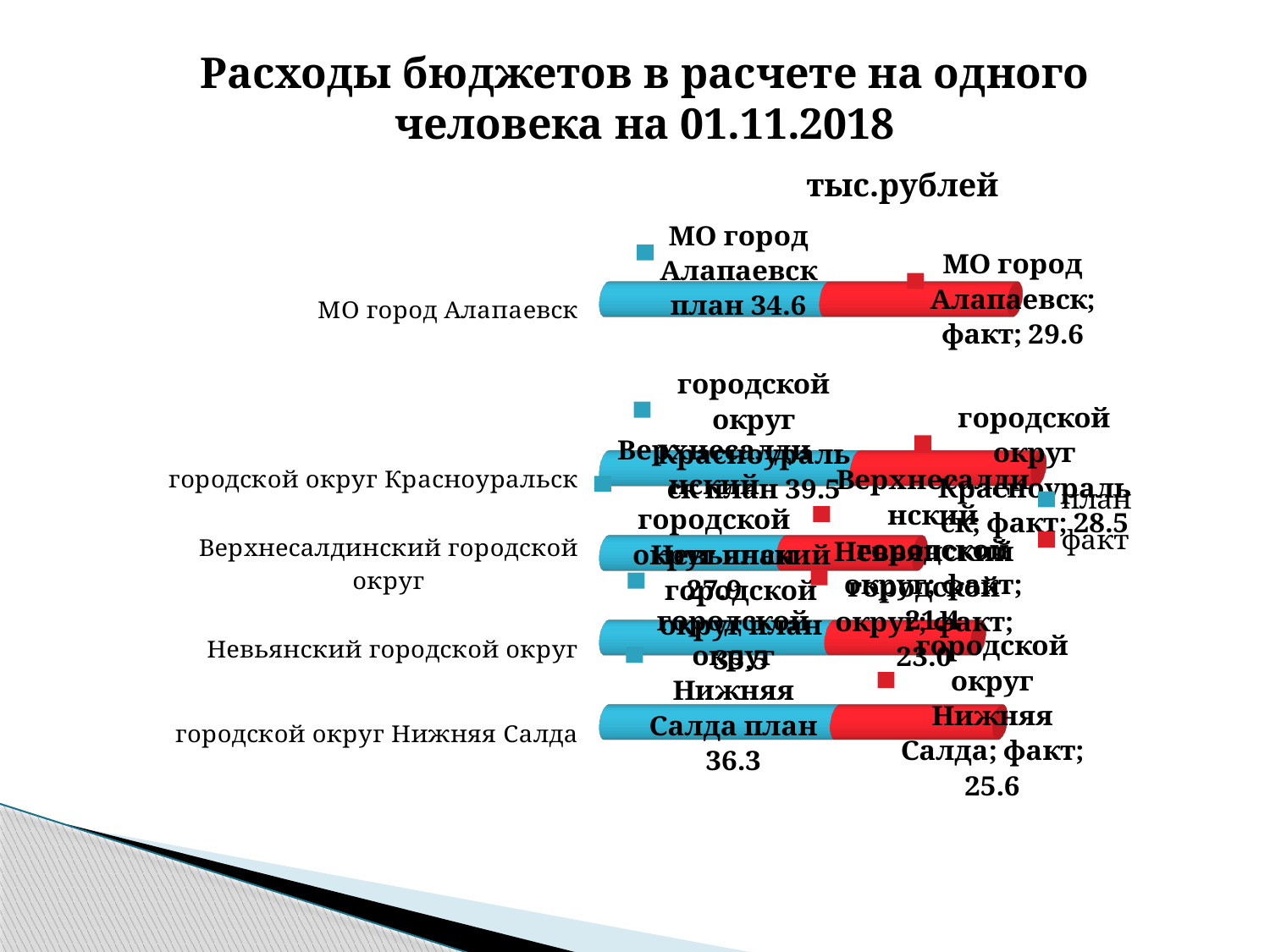
How many categories (municipalities) are plotted on the chart? 5 What kind of chart is shown on the slide? bar chart What is the difference between the план and факт values for городской округ Красноуральск? 11.0 What is the план value for городской округ Красноуральск? 39.5 How many series does the legend list? 2 What unit is stated for the values on the chart? тыс.рублей What is the факт value for городской округ Красноуральск? 28.5 What is the факт value for МО город Алапаевск? 29.6 What is the план value for городской округ Нижняя Салда? 36.3 What is the план value for МО город Алапаевск? 34.6 Which is larger for МО город Алапаевск, the план value or the факт value? план What is the факт value for городской округ Нижняя Салда? 25.6